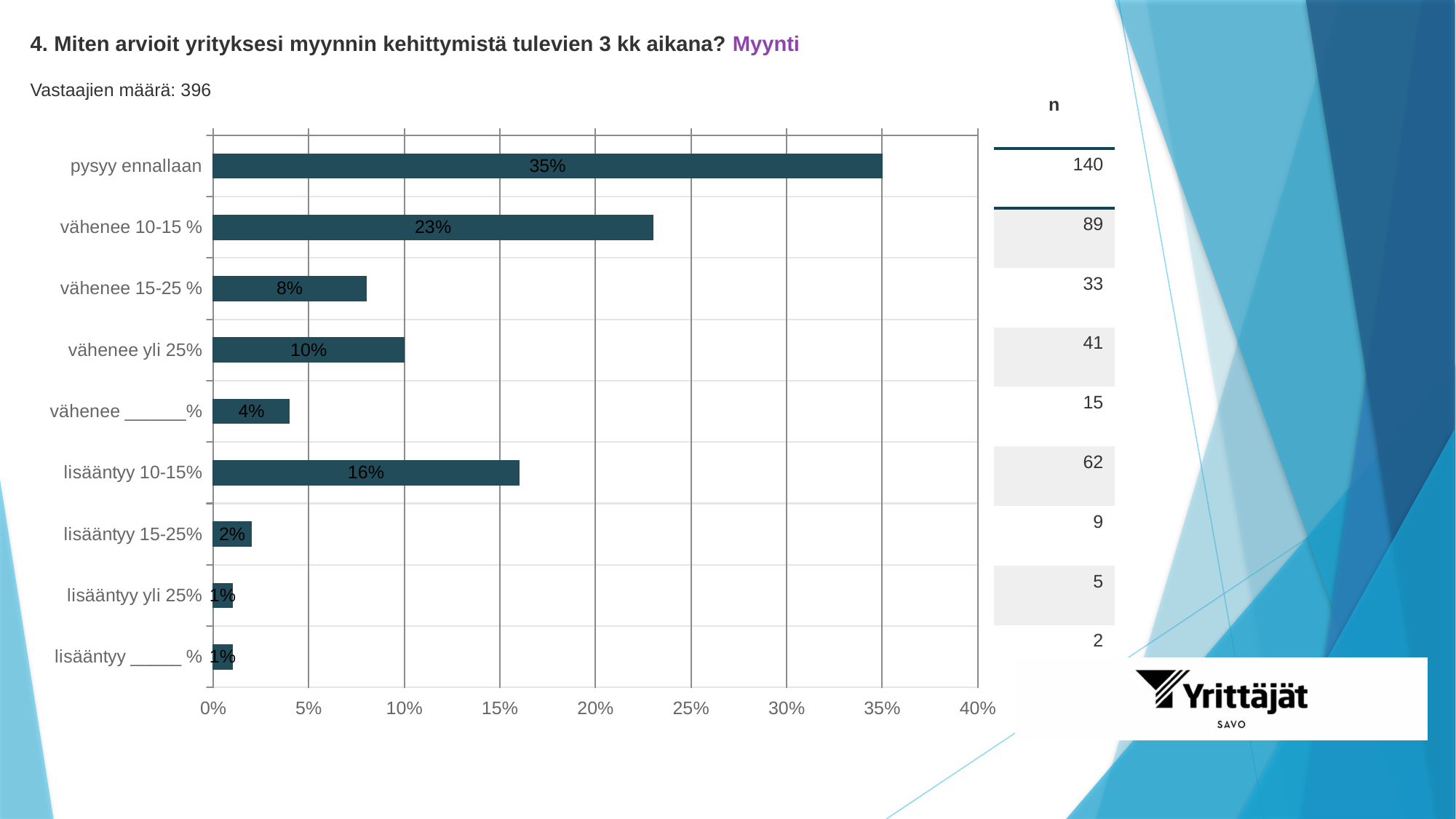
What is the maximum value shown on the x axis? 40% What is the difference in percentage points between "pysyy ennallaan" and "vähenee 10-15 %"? 12 What percentage of respondents answered "pysyy ennallaan"? 35% Is the value for "vähenee 10-15 %" greater or less than 20%? greater What kind of chart is shown on the slide? bar chart What is the total number of respondents stated on the slide? 396 Which is larger, the value for "vähenee 15-25 %" or the value for "vähenee yli 25%"? vähenee yli 25% What percentage of respondents answered "lisääntyy 10-15%"? 16% How many respondents (n) chose "vähenee 10-15 %"? 89 Which category has the highest percentage? pysyy ennallaan What is the value shown for "vähenee yli 25%"? 10% How many categories are shown in the chart? 9